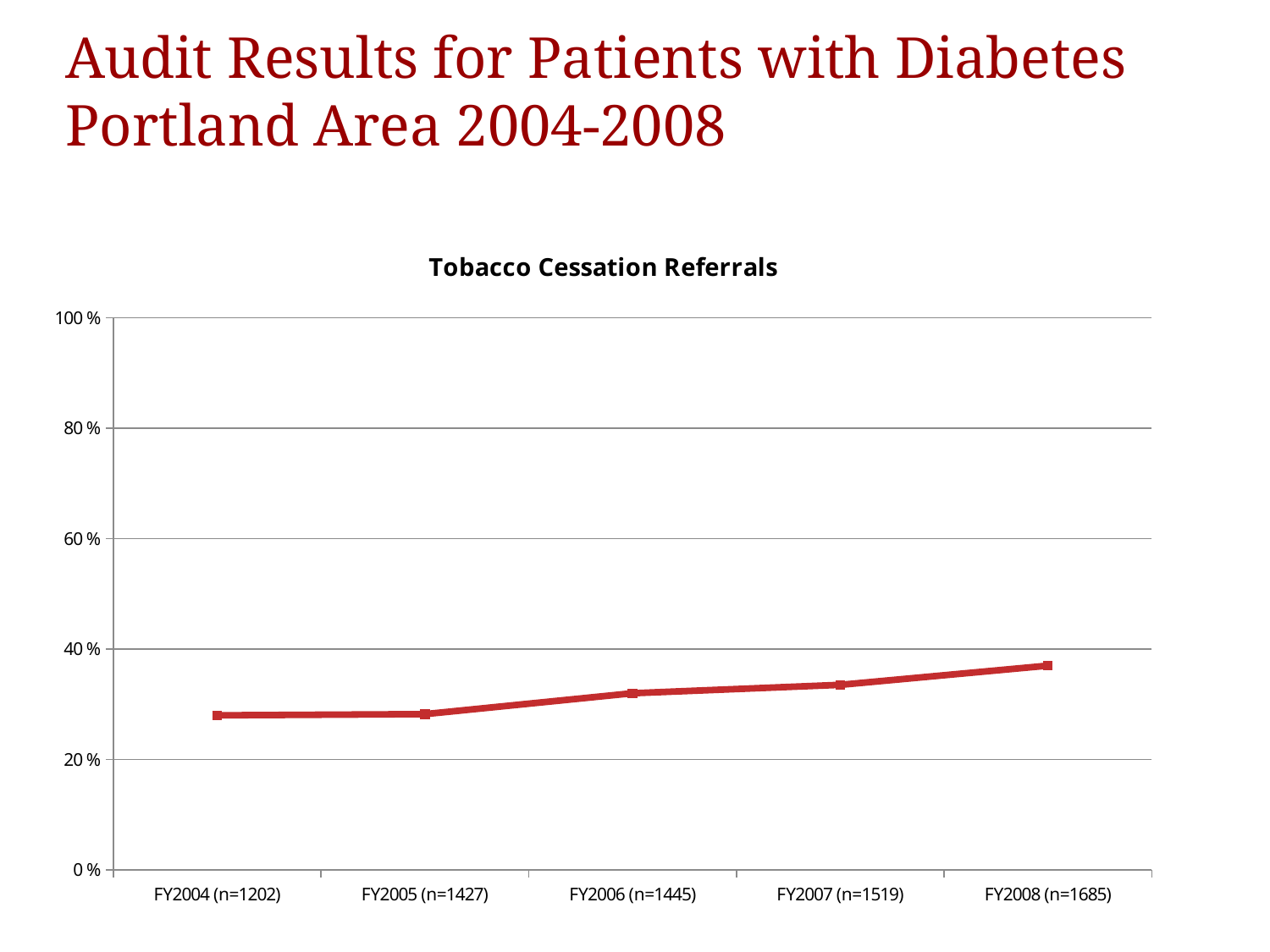
Which fiscal year has the highest tobacco cessation referral rate? FY2008 (n=1685) What is the title of the chart? Tobacco Cessation Referrals Which is larger, the value for FY2006 (n=1445) or the value for FY2004 (n=1202)? FY2006 (n=1445) Is the value for FY2004 (n=1202) greater or less than 20%? greater What is the sample size (n) shown in the x-axis label for FY2005? 1427 Is the value for FY2006 (n=1445) greater or less than 40%? less What kind of chart is shown on the slide? line chart Do the tobacco cessation referral values rise or fall from FY2004 to FY2008? rise Which is larger, the value for FY2008 (n=1685) or the value for FY2004 (n=1202)? FY2008 (n=1685) Is the value for FY2008 (n=1685) greater or less than 40%? less How many data points are plotted on the line? 5